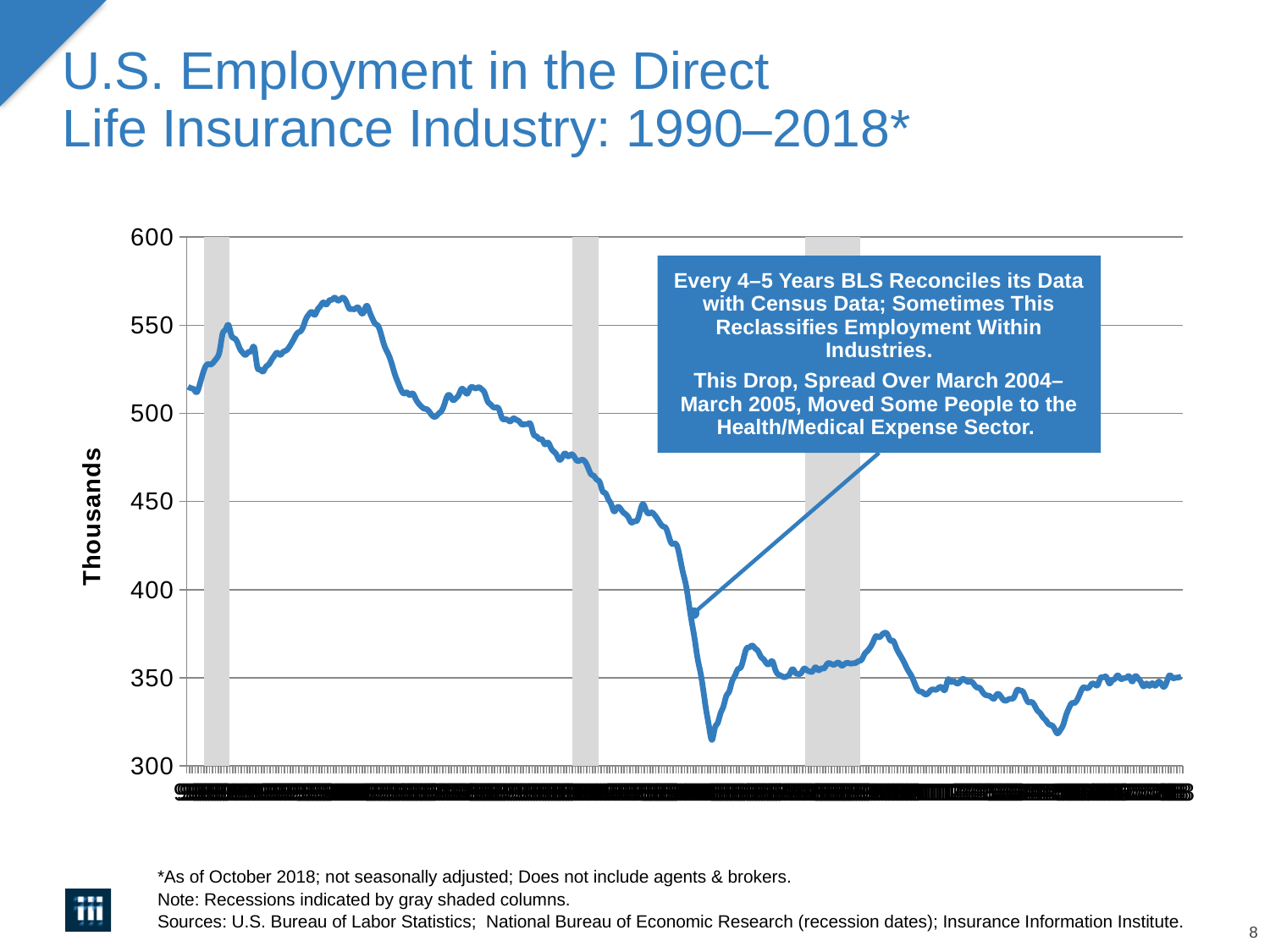
What kind of chart is shown on the slide? line chart Overall, do the values on the chart rise or fall from the left end to the right end of the x axis? fall Is the highest point reached by the line greater or less than 550? greater Is the value at the far left end of the line greater or less than 550? less What is the label on the vertical axis of the chart? Thousands Which is larger, the value at the far left end of the line or the value at the far right end? the far left end How many gray shaded recession columns appear on the chart? 3 Is the lowest point reached by the line greater or less than 350? less